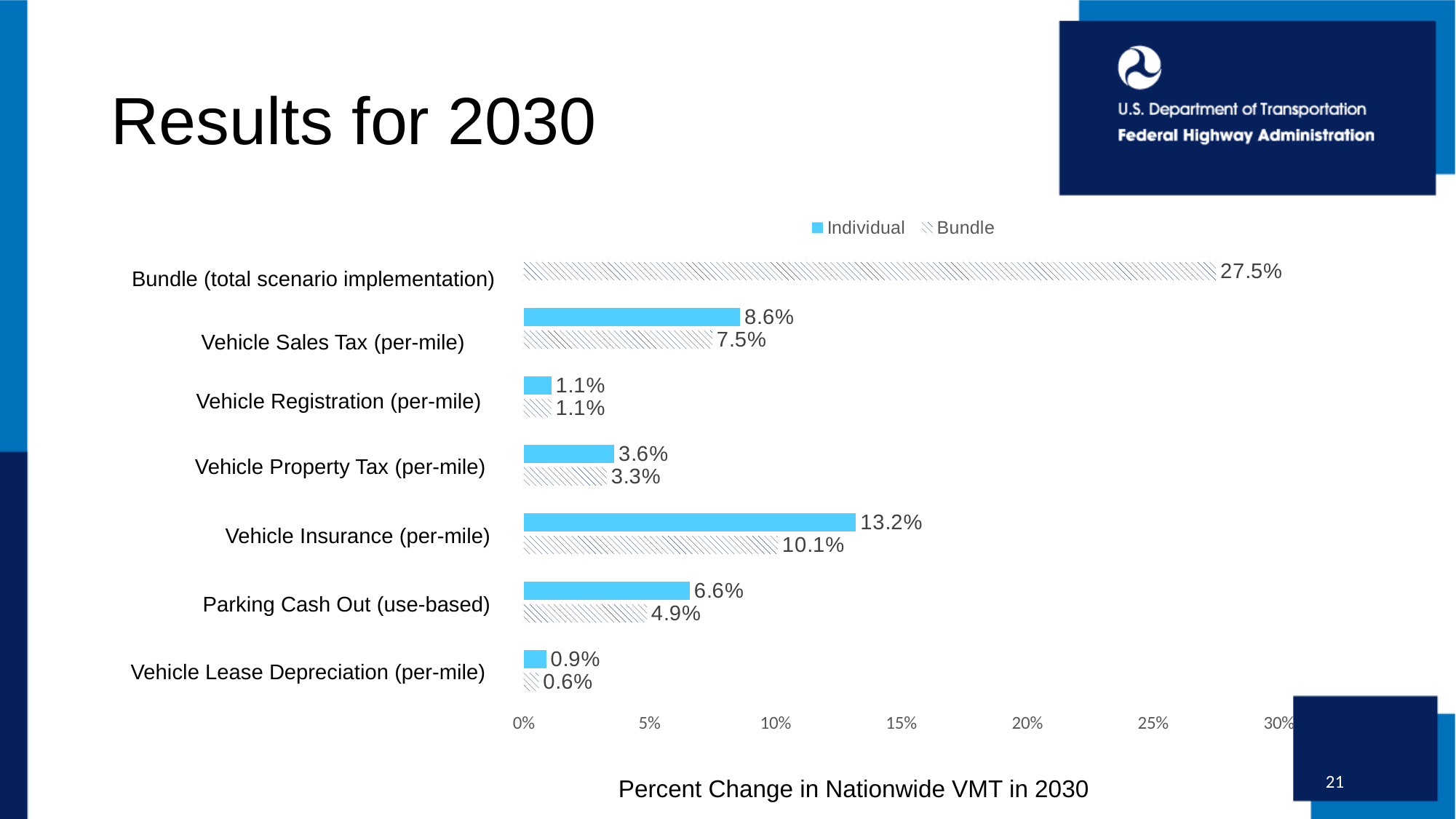
What is the value shown for Bundle (total scenario implementation)? 27.5% What is the difference between the Individual and Bundle values for Vehicle Insurance (per-mile)? 3.1% What is the Bundle value for Vehicle Sales Tax (per-mile)? 7.5% Which is larger, the Individual value for Vehicle Property Tax (per-mile) or the Individual value for Parking Cash Out (use-based)? Parking Cash Out (use-based) Which category has the highest Individual value? Vehicle Insurance (per-mile) What is the Bundle value for Parking Cash Out (use-based)? 4.9% What is the difference between the Individual values for Vehicle Sales Tax (per-mile) and Parking Cash Out (use-based)? 2.0% What is the axis title shown below the chart? Percent Change in Nationwide VMT in 2030 Which category has the lowest Individual value? Vehicle Lease Depreciation (per-mile) What kind of chart is shown on the slide? Bar chart What is the Individual value for Vehicle Insurance (per-mile)? 13.2% How many series does the legend list? 2